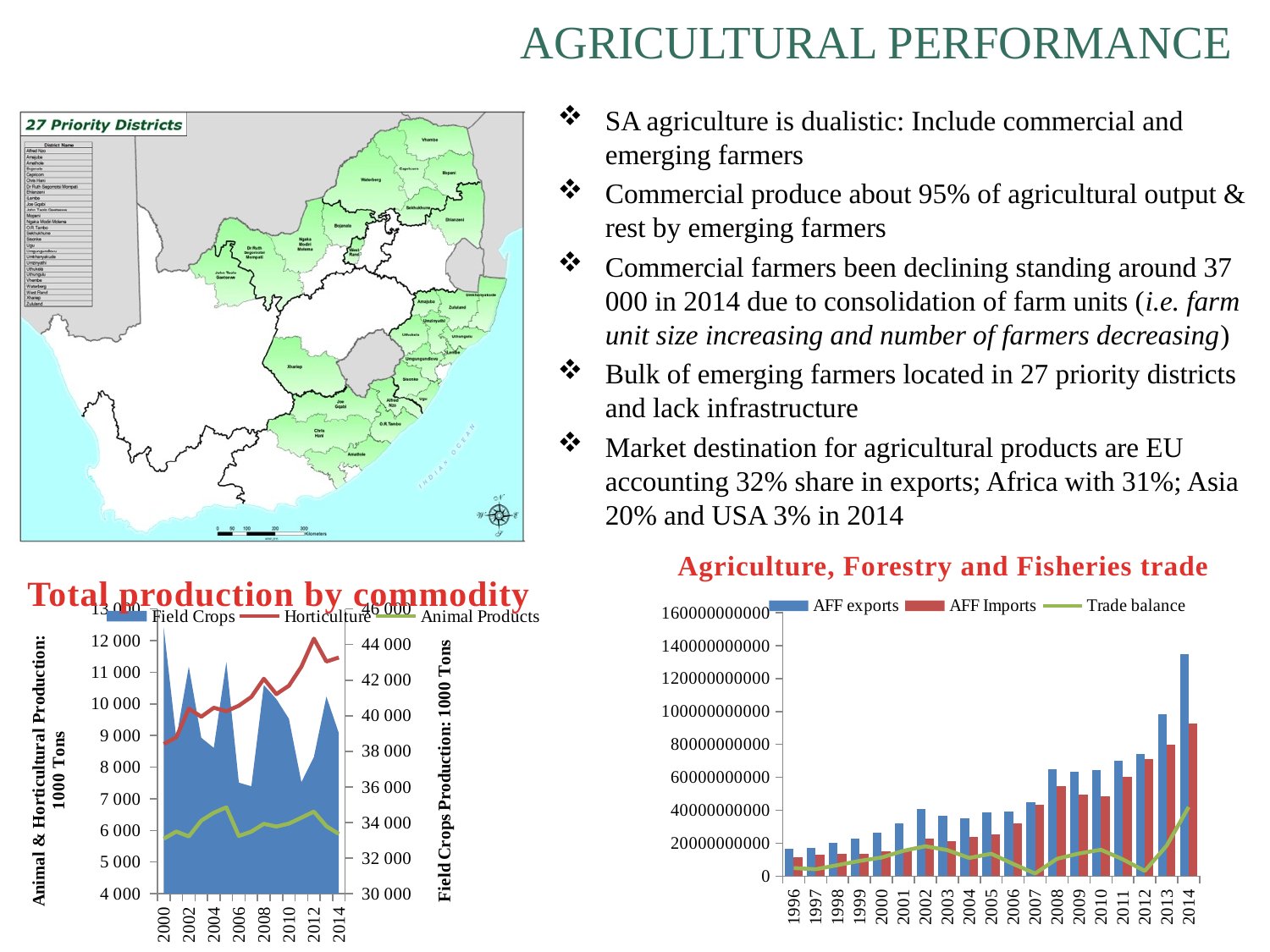
In the 'Agriculture, Forestry and Fisheries trade' chart, how many years are shown on the x axis? 19 In the 'Agriculture, Forestry and Fisheries trade' chart, which is larger in 2008: AFF exports or AFF Imports? AFF exports What kind of chart is the 'Agriculture, Forestry and Fisheries trade' chart? Bar chart with a line In the 'Agriculture, Forestry and Fisheries trade' chart, is the value of AFF exports in 2014 greater or less than 120000000000? greater In the 'Agriculture, Forestry and Fisheries trade' chart, how many series does the legend list? 3 In the 'Total production by commodity' chart, which year has the highest Field Crops production? 2000 In the 'Total production by commodity' chart, how many series does the legend list? 3 In the 'Total production by commodity' chart, which year has the highest Horticulture production? 2012 In the 'Agriculture, Forestry and Fisheries trade' chart, what are the legend entries? AFF exports, AFF Imports, Trade balance In the 'Agriculture, Forestry and Fisheries trade' chart, is the value of AFF Imports in 2014 greater or less than 80000000000? greater In the 'Agriculture, Forestry and Fisheries trade' chart, do AFF exports generally rise or fall from 1996 to 2014? rise In the 'Agriculture, Forestry and Fisheries trade' chart, which year has the highest AFF exports? 2014